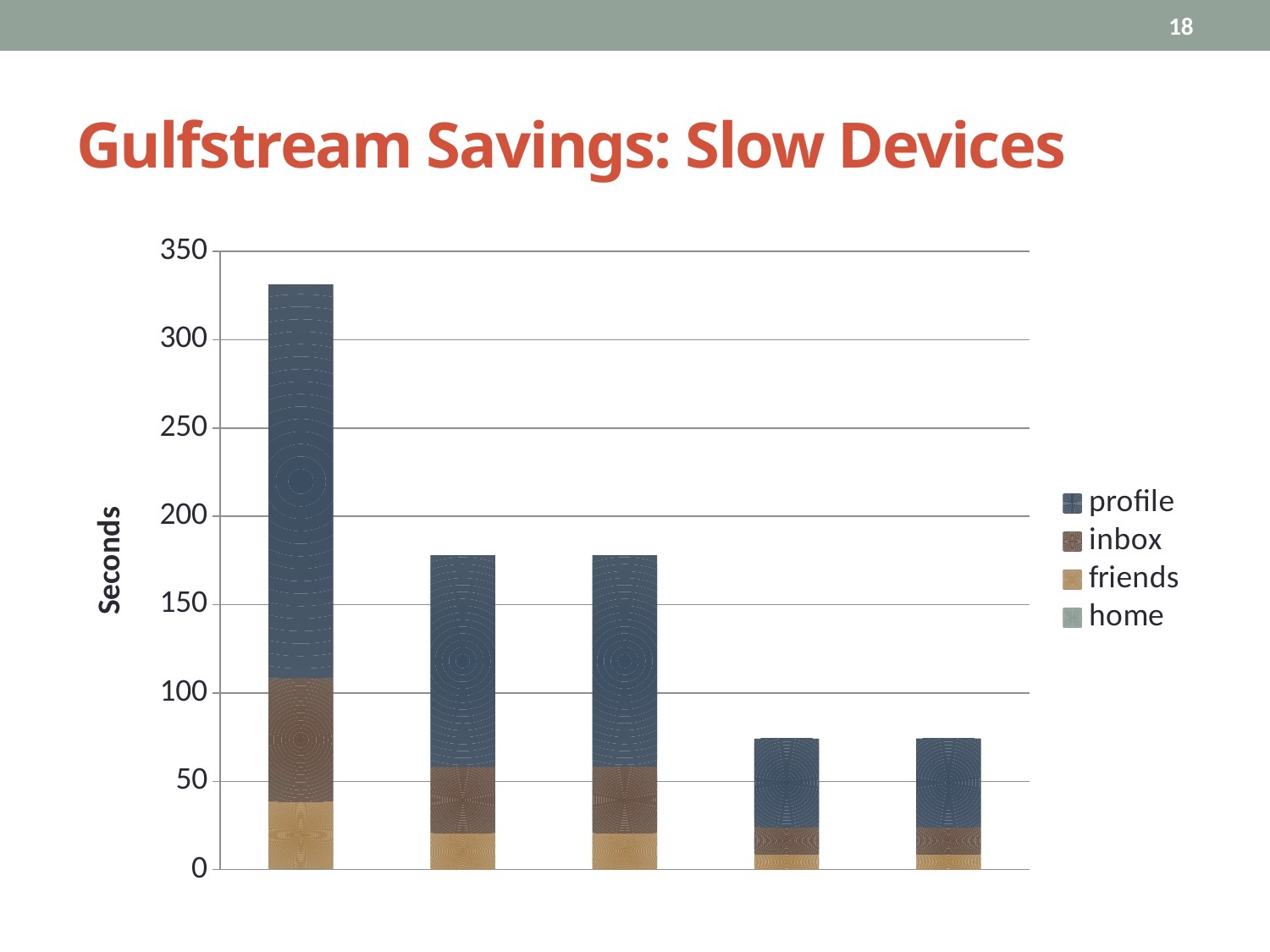
Do the bar totals generally rise or fall from left to right? fall What kind of chart is shown on the slide? bar chart What is the title of the slide containing the chart? Gulfstream Savings: Slow Devices How many series does the legend list? 4 What is the label on the vertical axis? Seconds Which is larger, the total of the first bar or the total of the third bar? the first bar How many bars are plotted in the chart? 5 Which bar is the tallest, counting from the left? the first bar Is the total of the fourth bar from the left greater or less than 100? less Is the total of the fifth (rightmost) bar greater or less than 50? greater Is the total of the first (leftmost) bar greater or less than 300? greater